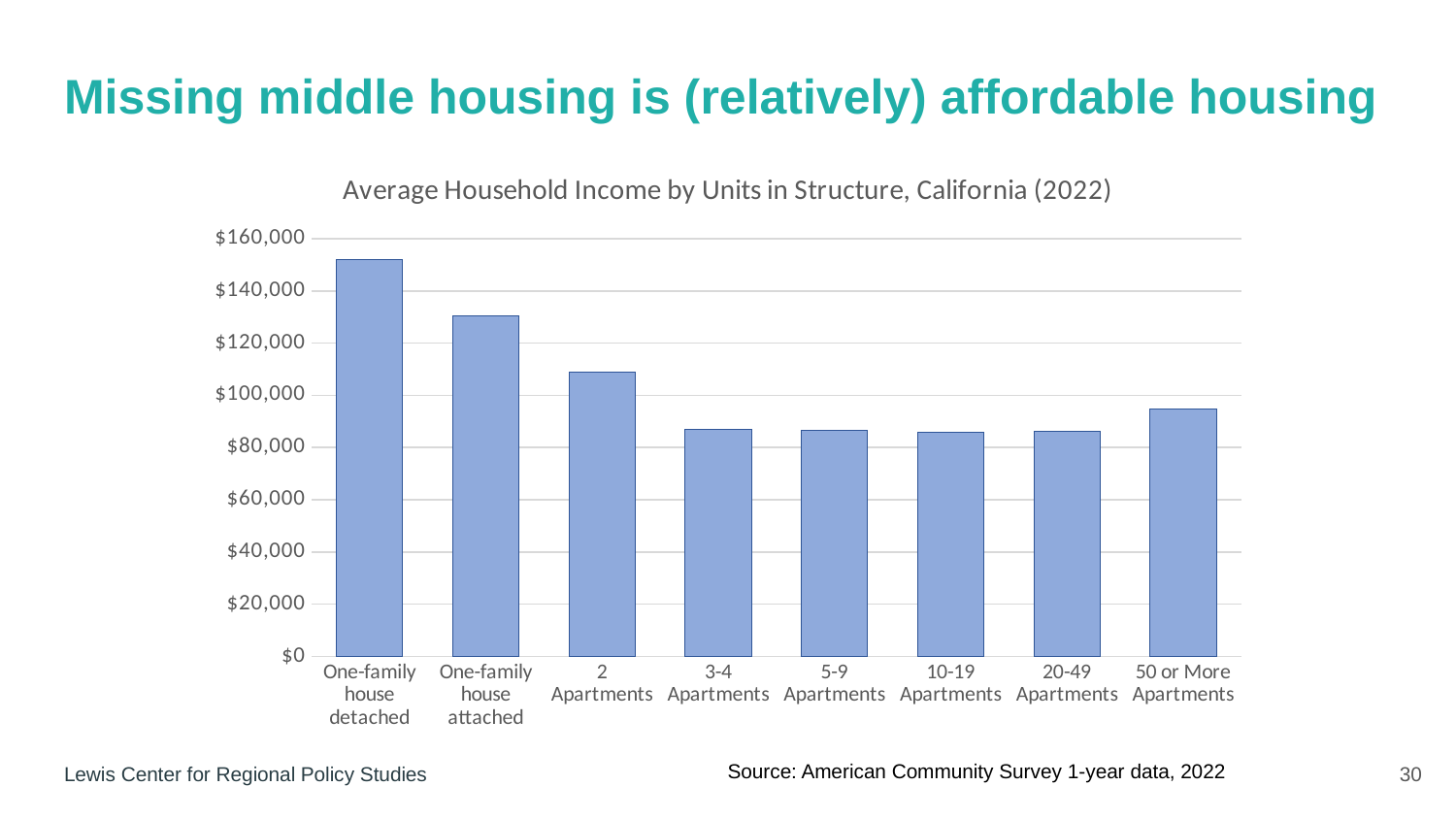
Is the value for One-family house detached greater or less than $140,000? greater What is the title of the chart? Average Household Income by Units in Structure, California (2022) Do the values rise or fall moving from One-family house detached to 2 Apartments along the x axis? fall How many categories are shown on the x axis of the chart? 8 Is the value for 50 or More Apartments greater or less than $100,000? less Which category has the highest average household income? One-family house detached Is the value for 3-4 Apartments greater or less than $100,000? less What kind of chart is shown on the slide? Bar chart Which is larger, the value for One-family house attached or the value for 2 Apartments? One-family house attached